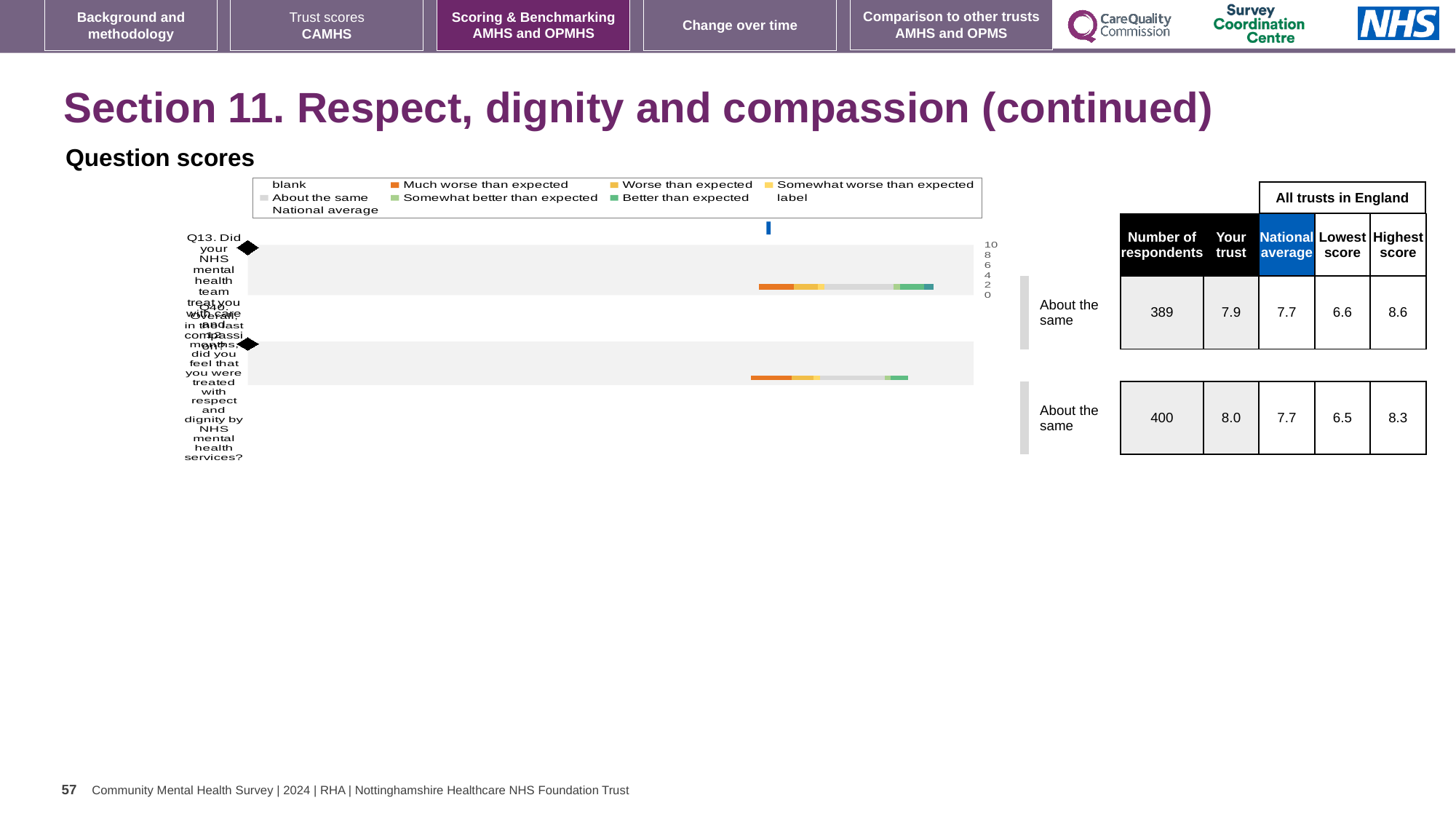
In the table next to the chart, what is the number of respondents for the first row? 389 In the table next to the chart, what is the "Your trust" score for the second row? 8.0 What is the heading above the chart on this slide? Question scores What kind of chart is shown under "Question scores"? Bar chart What benchmark category label is shown beside both rows of the chart? About the same In the table next to the chart, what is the highest score for the first row? 8.6 In the table next to the chart, what is the national average for the second row? 7.7 For the first row of the table, which is larger: the "Your trust" score or the national average? Your trust For the first row of the table, what is the difference between the highest score and the lowest score? 2.0 How many entries does the legend of the "Question scores" chart list? 9 For the second row of the table, what is the difference between the highest score and the lowest score? 1.8 How many questions (bars) are plotted in the "Question scores" chart? 2